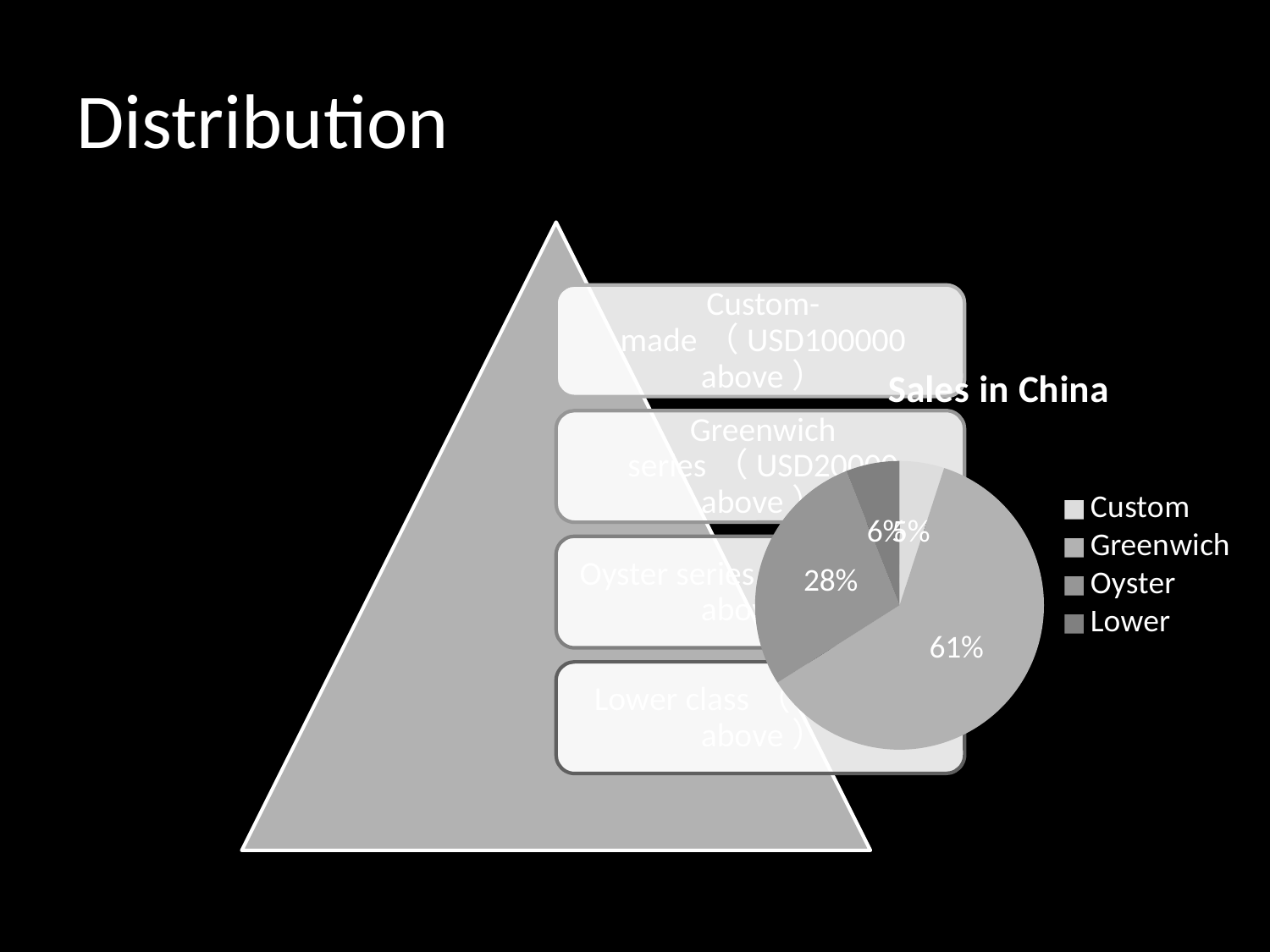
In the "Sales in China" pie chart, which is larger, Greenwich or Oyster? Greenwich What are the legend entries of the "Sales in China" pie chart, in order? Custom, Greenwich, Oyster, Lower In the "Sales in China" pie chart, what share of the pie do Greenwich and Oyster make up together? 89% What kind of chart is the "Sales in China" chart? pie chart In the "Sales in China" pie chart, what share does Oyster have? 28% In the "Sales in China" pie chart, what is the difference between the Greenwich and Oyster shares? 33 percentage points Which category has the largest slice in the "Sales in China" pie chart? Greenwich In the "Sales in China" pie chart, what share does Greenwich have? 61% What is the title of the pie chart on the slide? Sales in China How many categories does the legend of the "Sales in China" pie chart list? 4